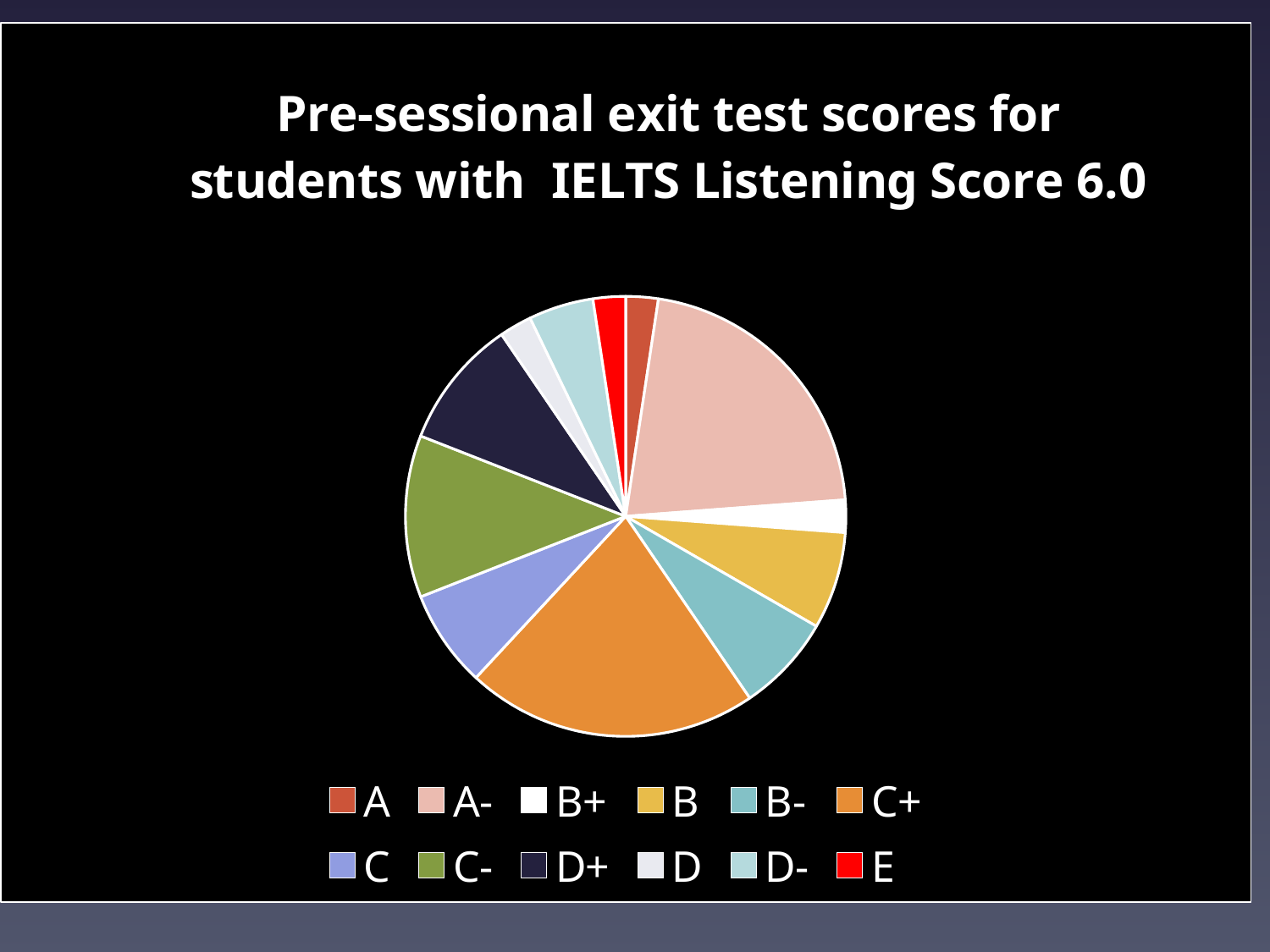
What colour represents the E grade in the chart? red Which slice is larger, D+ or D? D+ Which slice is larger, C- or C? C- How many grade categories does the legend list? 12 What is the title of the chart? Pre-sessional exit test scores for students with IELTS Listening Score 6.0 Which slice is larger, A- or A? A- What kind of chart is shown on the slide? pie chart